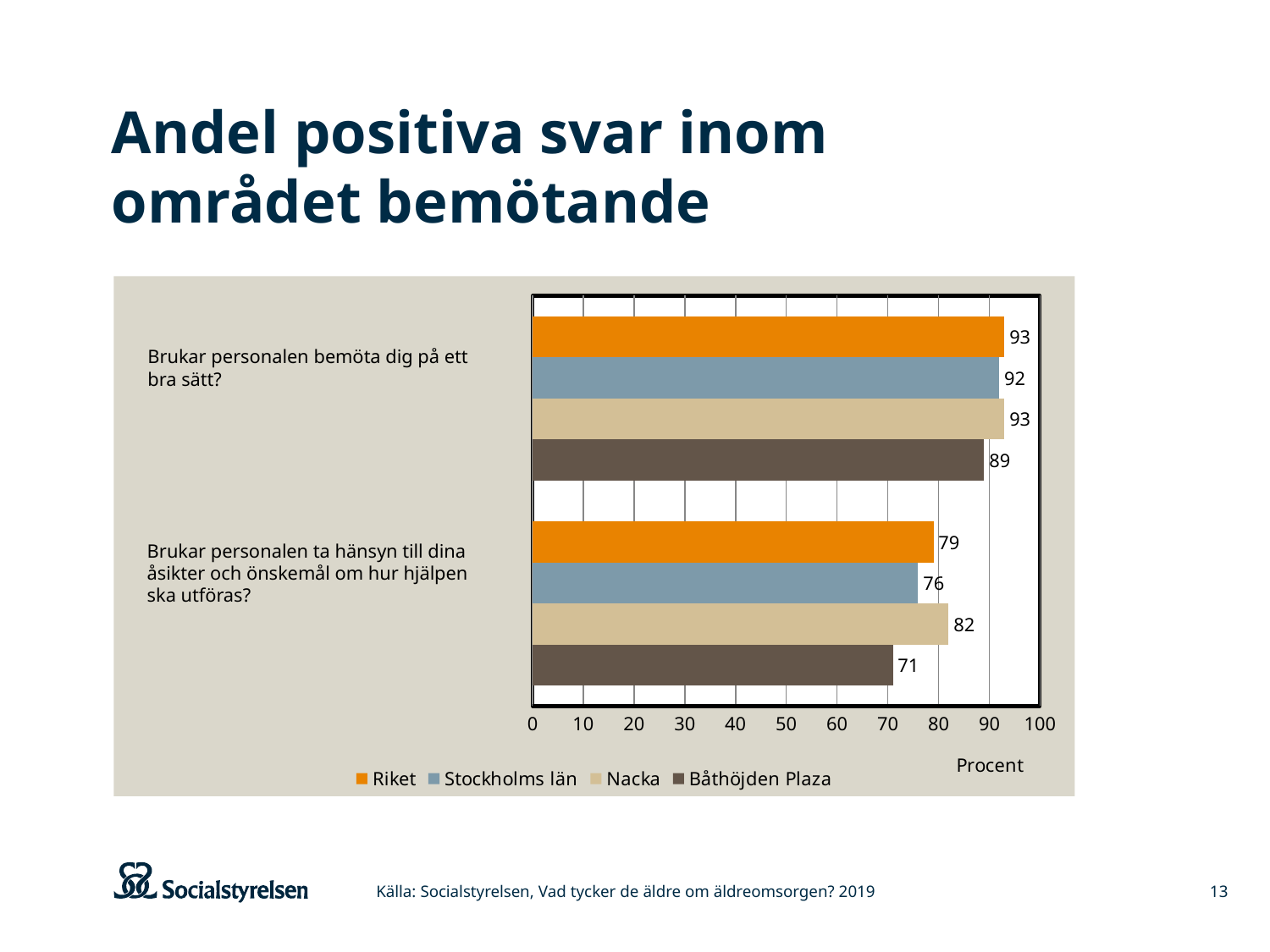
What value is shown for Riket on the question "Brukar personalen bemöta dig på ett bra sätt?" 93 What unit is labelled on the horizontal axis of the chart? Procent Which series has the highest value on the question "Brukar personalen ta hänsyn till dina åsikter och önskemål om hur hjälpen ska utföras?" Nacka Which series has the lowest value on the question "Brukar personalen ta hänsyn till dina åsikter och önskemål om hur hjälpen ska utföras?" Båthöjden Plaza Which is larger for Båthöjden Plaza: the value for "Brukar personalen bemöta dig på ett bra sätt?" or the value for "Brukar personalen ta hänsyn till dina åsikter och önskemål om hur hjälpen ska utföras?" Brukar personalen bemöta dig på ett bra sätt? What is the difference between the Nacka value and the Båthöjden Plaza value on the question "Brukar personalen ta hänsyn till dina åsikter och önskemål om hur hjälpen ska utföras?" 11 What value is shown for Stockholms län on the question "Brukar personalen ta hänsyn till dina åsikter och önskemål om hur hjälpen ska utföras?" 76 What kind of chart is shown on the slide? Bar chart What value is shown for Båthöjden Plaza on the question "Brukar personalen bemöta dig på ett bra sätt?" 89 Is the value for Riket on the question "Brukar personalen ta hänsyn till dina åsikter och önskemål om hur hjälpen ska utföras?" greater or less than 70? greater What value is shown for Nacka on the question "Brukar personalen ta hänsyn till dina åsikter och önskemål om hur hjälpen ska utföras?" 82 How many series does the legend list? 4